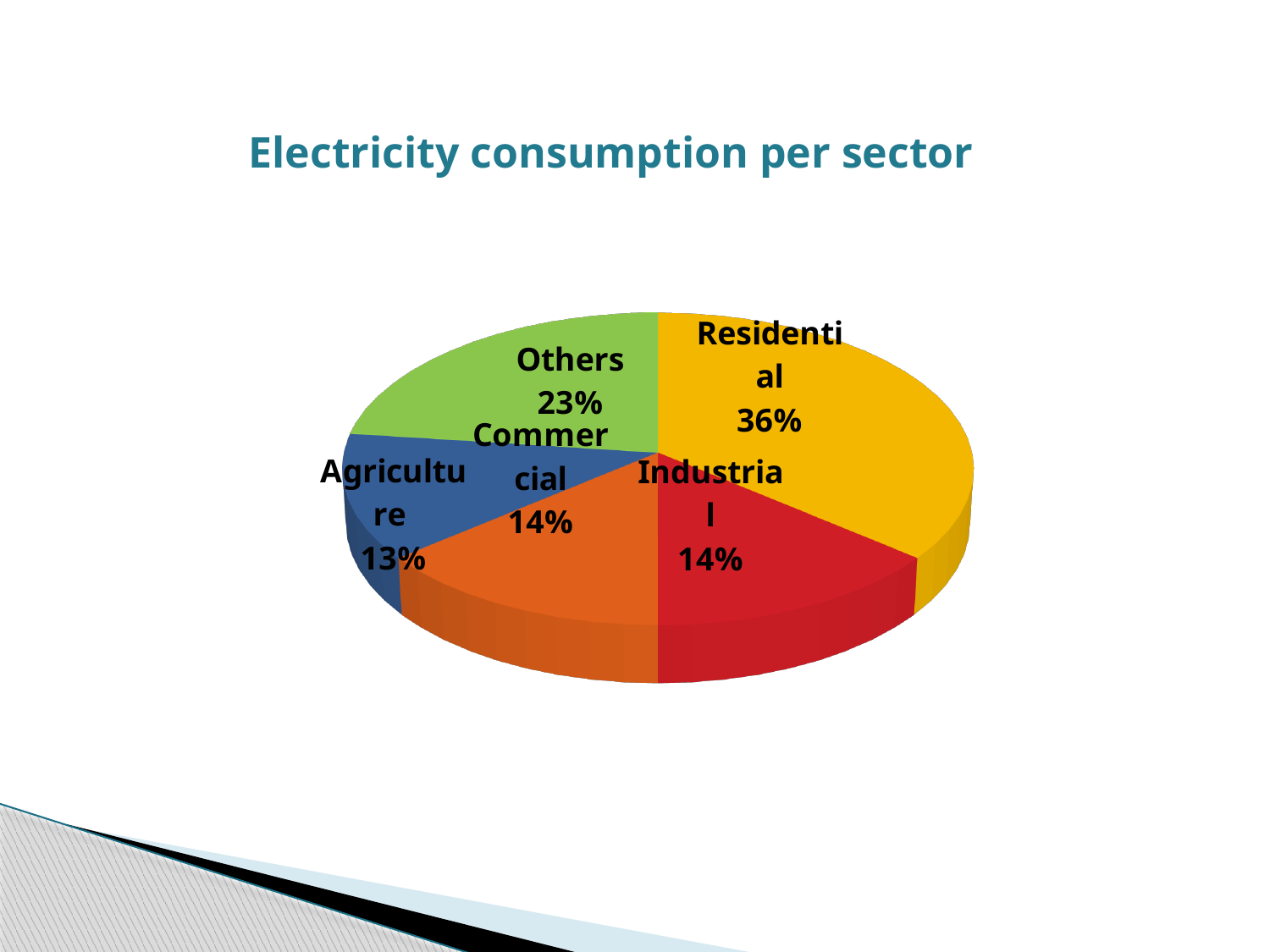
Which slice is larger, Others or Agriculture? Others What percentage is shown for the Others slice? 23% Which sector has the smallest share of electricity consumption? Agriculture What kind of chart is shown on the slide? pie chart What share of electricity consumption does the Residential sector account for? 36% Which sector has the largest share of electricity consumption? Residential What is the difference in percentage points between the Residential and Others slices? 13 What percentage is shown for Agriculture? 13% What percentage is shown for the Industrial sector? 14% What colour is the Residential slice? yellow What is the title of the chart? Electricity consumption per sector How many sectors (slices) are shown in the pie chart? 5